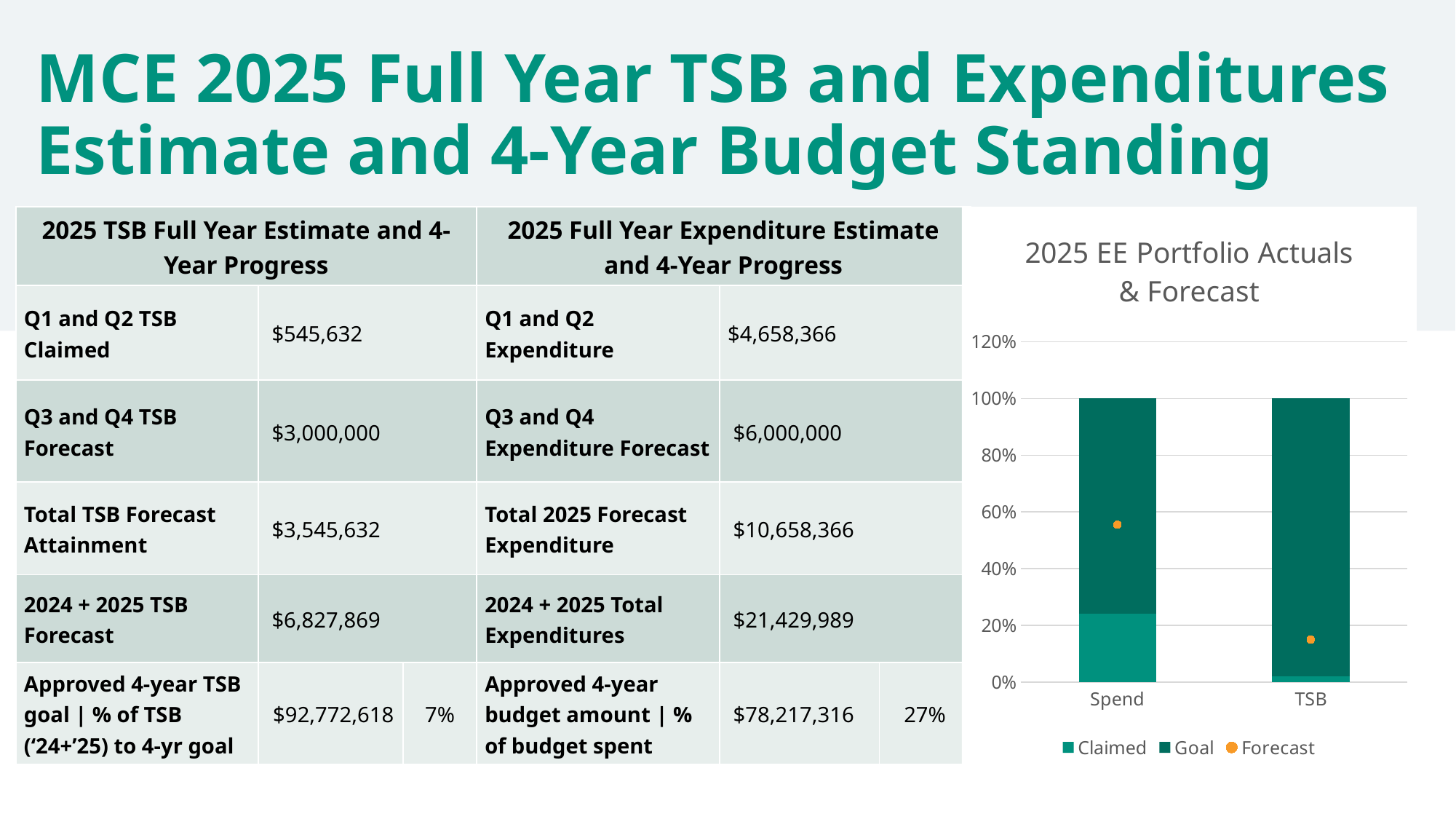
In the "2025 EE Portfolio Actuals & Forecast" chart, is the Forecast value for Spend greater or less than 40%? greater What is the title of the chart on the right side of the slide? 2025 EE Portfolio Actuals & Forecast In the "2025 EE Portfolio Actuals & Forecast" chart, which category has the larger Claimed value, Spend or TSB? Spend In the "2025 EE Portfolio Actuals & Forecast" chart, which category has the larger Forecast value, Spend or TSB? Spend How many categories are shown on the x axis of the "2025 EE Portfolio Actuals & Forecast" chart? 2 How many series does the legend of the "2025 EE Portfolio Actuals & Forecast" chart list? 3 What kind of chart is the "2025 EE Portfolio Actuals & Forecast" chart? bar chart In the "2025 EE Portfolio Actuals & Forecast" chart, is the Claimed value for TSB greater or less than 20%? less In the "2025 EE Portfolio Actuals & Forecast" chart, is the Claimed value for Spend greater or less than 40%? less